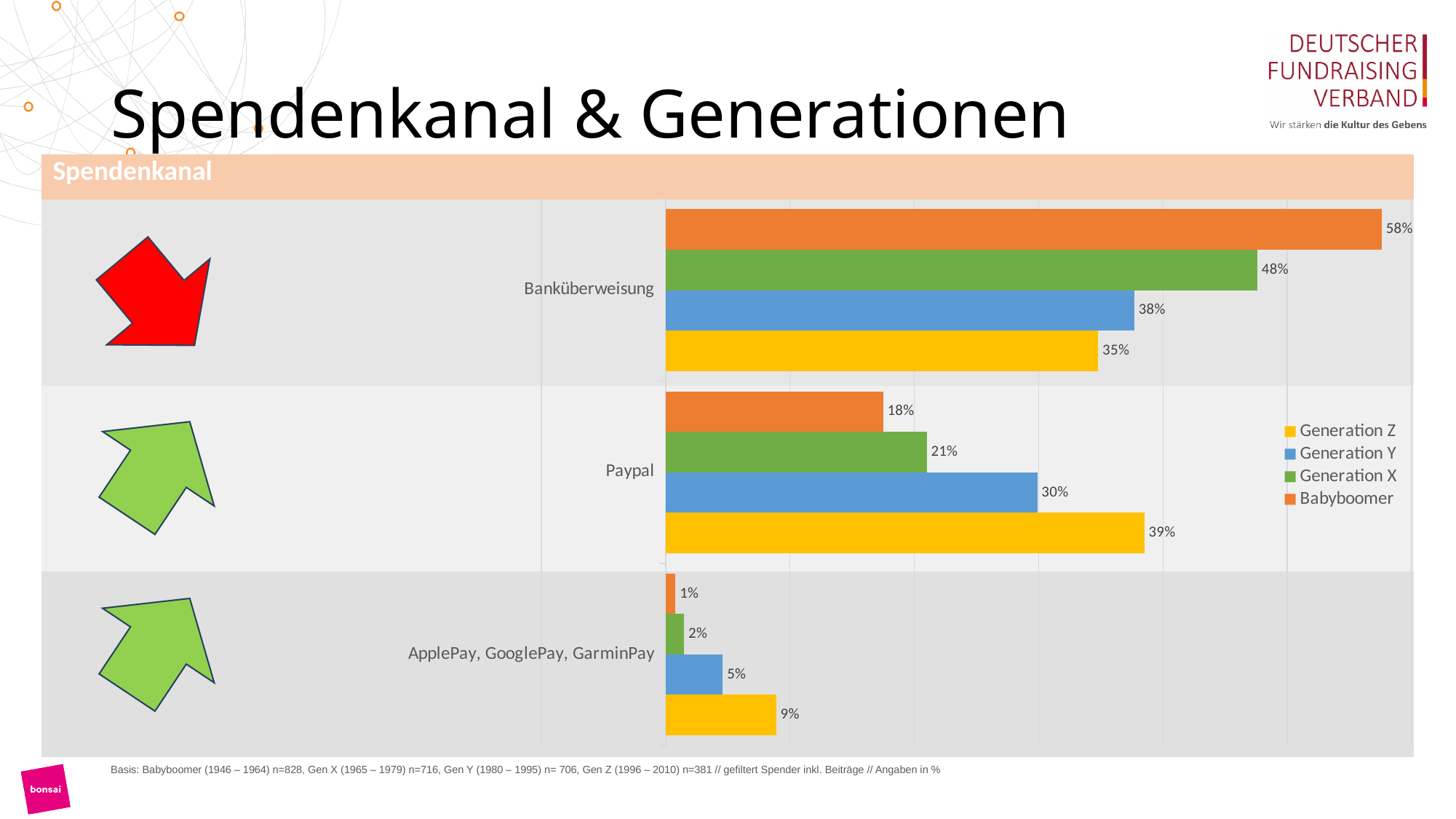
What is the difference between the Babyboomer and Generation Z values for Banküberweisung? 23% What is the value for Generation Z for Paypal? 39% Which generation has the highest value for Banküberweisung? Babyboomer What kind of chart is shown on the slide? Bar chart For Paypal, which is larger: the value for Generation Y or the value for Babyboomer? Generation Y What is the value for Babyboomer for Banküberweisung? 58% Which generation has the lowest value for ApplePay, GooglePay, GarminPay? Babyboomer Which colour represents Generation X in the chart? Green How many donation channel categories are shown on the chart? 3 What is the value for Generation Y for ApplePay, GooglePay, GarminPay? 5% How many series does the legend list? 4 What is the value for Generation X for Paypal? 21%